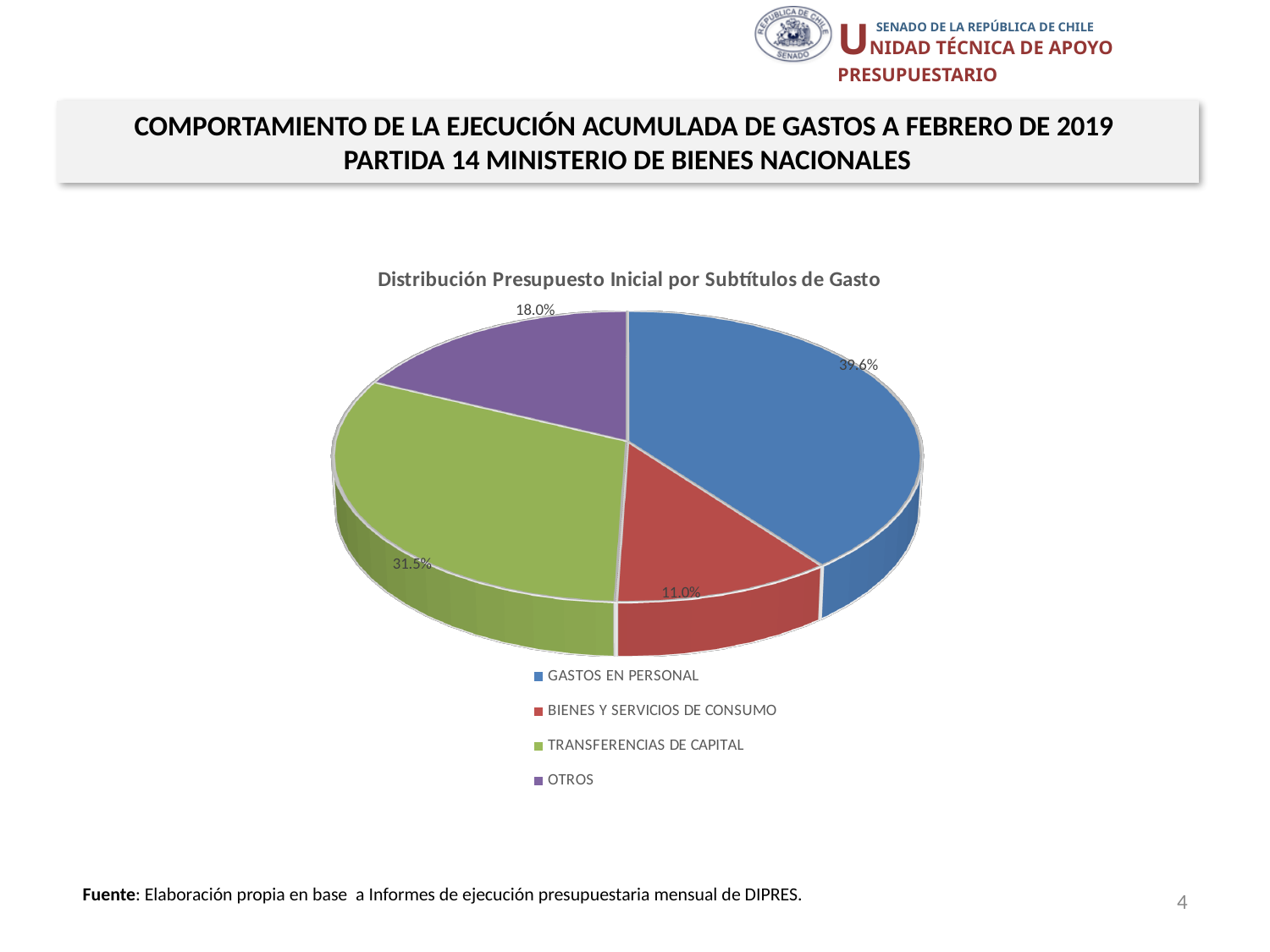
What share of the pie does GASTOS EN PERSONAL represent? 39.6% How many slices does the pie chart have? 4 What share of the pie does TRANSFERENCIAS DE CAPITAL represent? 31.5% What share of the pie does OTROS represent? 18.0% What is the title of the chart? Distribución Presupuesto Inicial por Subtítulos de Gasto Which category has the largest share of the pie? GASTOS EN PERSONAL What is the difference in percentage points between GASTOS EN PERSONAL and TRANSFERENCIAS DE CAPITAL? 8.1 Which is larger, the share for OTROS or the share for BIENES Y SERVICIOS DE CONSUMO? OTROS Which category has the smallest share of the pie? BIENES Y SERVICIOS DE CONSUMO Which colour represents TRANSFERENCIAS DE CAPITAL in the pie chart? Green What kind of chart is shown on the slide? Pie chart